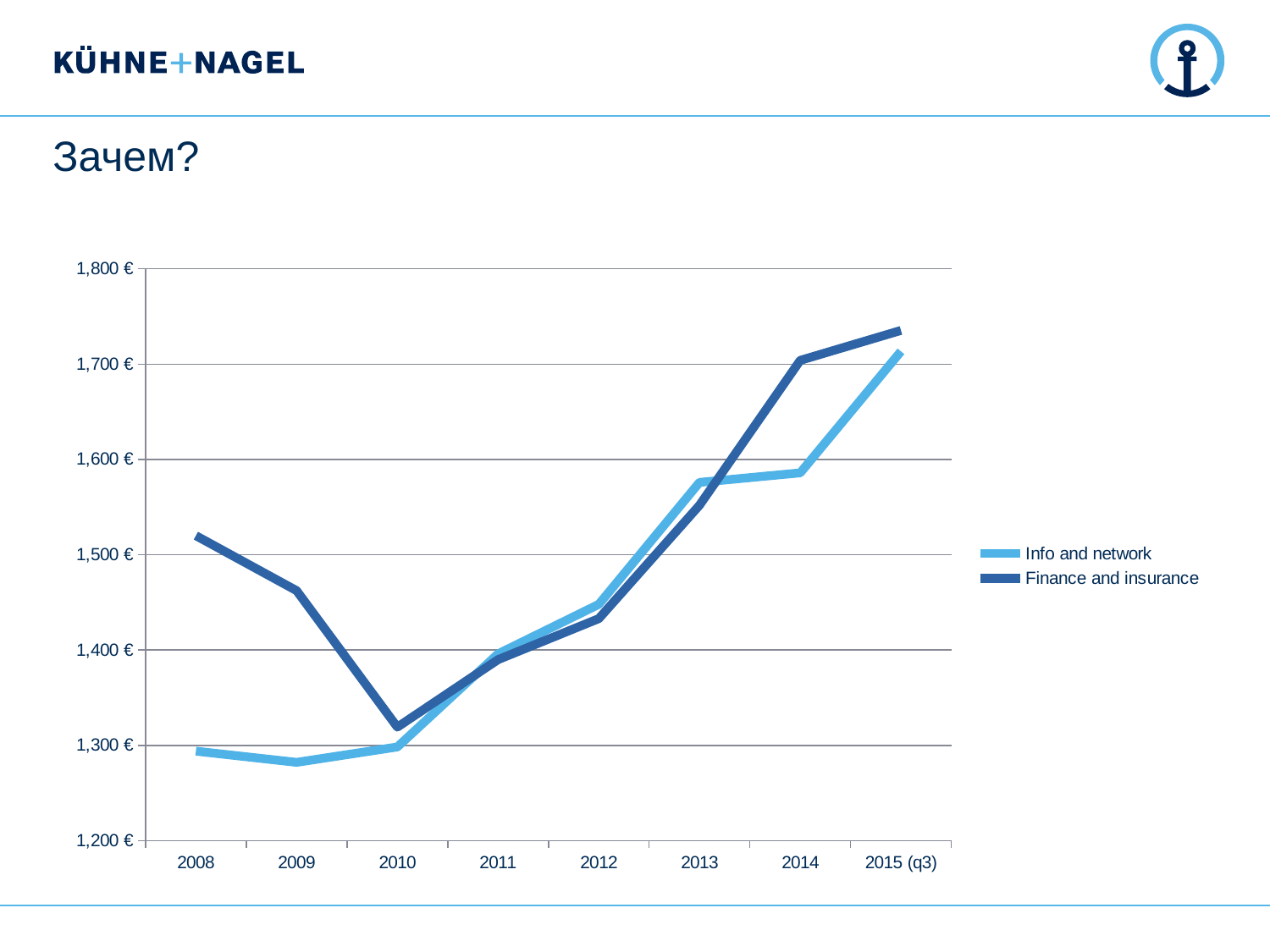
Is the value for Info and network in 2014 greater or less than 1,600 €? less How many years are shown on the x axis of the chart? 8 In 2008, which series has the higher value, Info and network or Finance and insurance? Finance and insurance Does the Finance and insurance line rise or fall from 2008 to 2010? fall Is the value for Finance and insurance in 2010 greater or less than 1,300 €? greater At which point on the x axis does the Finance and insurance line reach its highest value? 2015 (q3) What kind of chart is shown on the slide? line chart Which series is drawn in the darker blue line? Finance and insurance Is the value for Finance and insurance in 2009 greater or less than 1,500 €? less In which year is the Finance and insurance line at its lowest? 2010 How many series does the legend list? 2 In which year is the Info and network line at its lowest? 2009